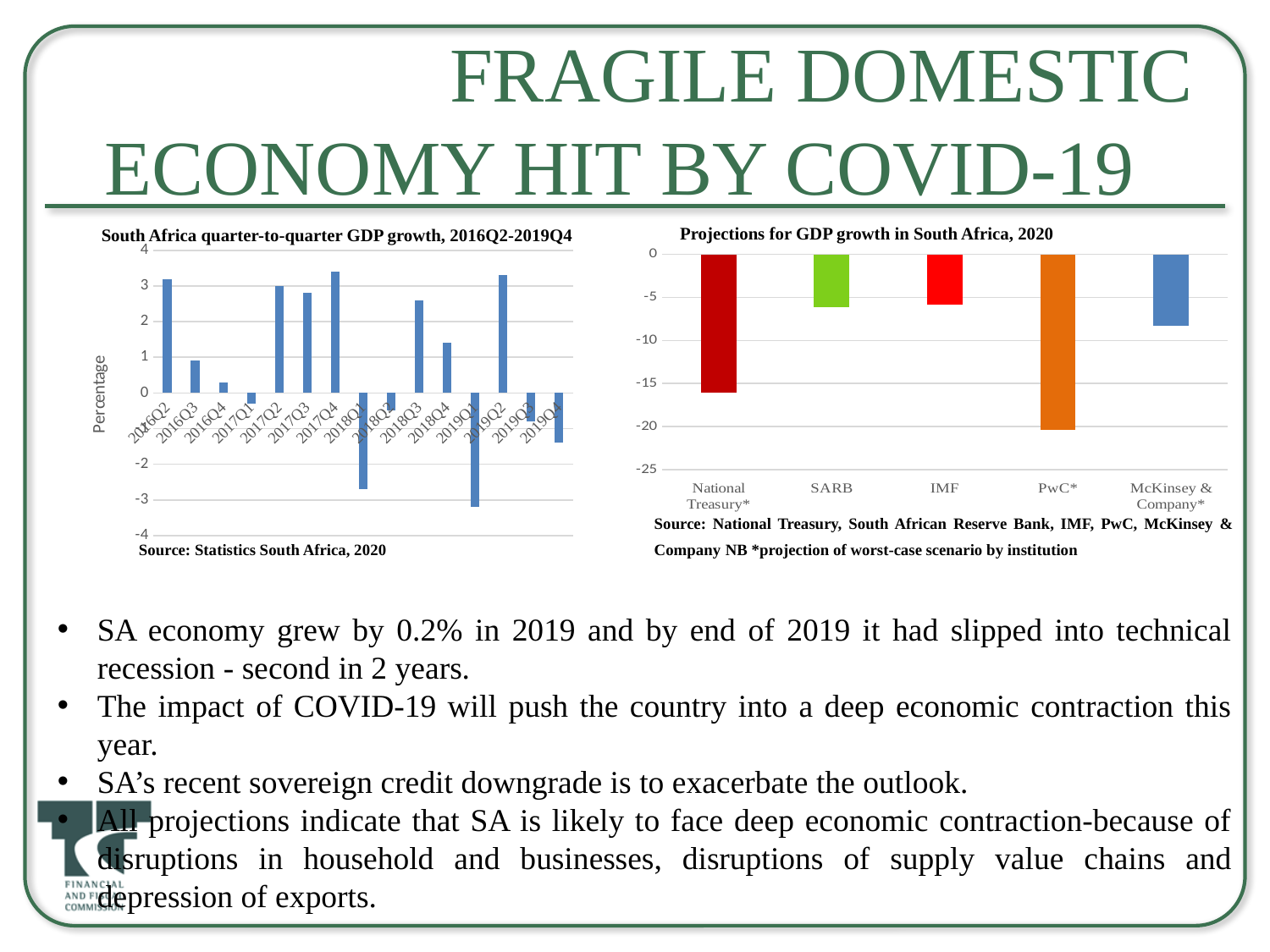
In the left chart, 'South Africa quarter-to-quarter GDP growth', which quarter has the lowest value? 2019Q1 In the left chart, 'South Africa quarter-to-quarter GDP growth', which is larger, the value for 2016Q3 or the value for 2018Q4? 2018Q4 What is the y-axis label of the left chart, 'South Africa quarter-to-quarter GDP growth, 2016Q2-2019Q4'? Percentage In the right chart, 'Projections for GDP growth in South Africa, 2020', which is larger, the value for National Treasury* or the value for SARB? SARB In the right chart, 'Projections for GDP growth in South Africa, 2020', which institution has the lowest projection? PwC* In the left chart, 'South Africa quarter-to-quarter GDP growth', is the value for 2018Q1 greater or less than -2? less In the left chart, 'South Africa quarter-to-quarter GDP growth', is the value for 2016Q2 greater or less than 3? greater How many institutions are shown in the right chart, 'Projections for GDP growth in South Africa, 2020'? 5 How many quarters are plotted in the left chart, 'South Africa quarter-to-quarter GDP growth, 2016Q2-2019Q4'? 15 What kind of chart is the left chart, 'South Africa quarter-to-quarter GDP growth, 2016Q2-2019Q4'? bar chart In the right chart, 'Projections for GDP growth in South Africa, 2020', is the value for McKinsey & Company* greater or less than -10? greater